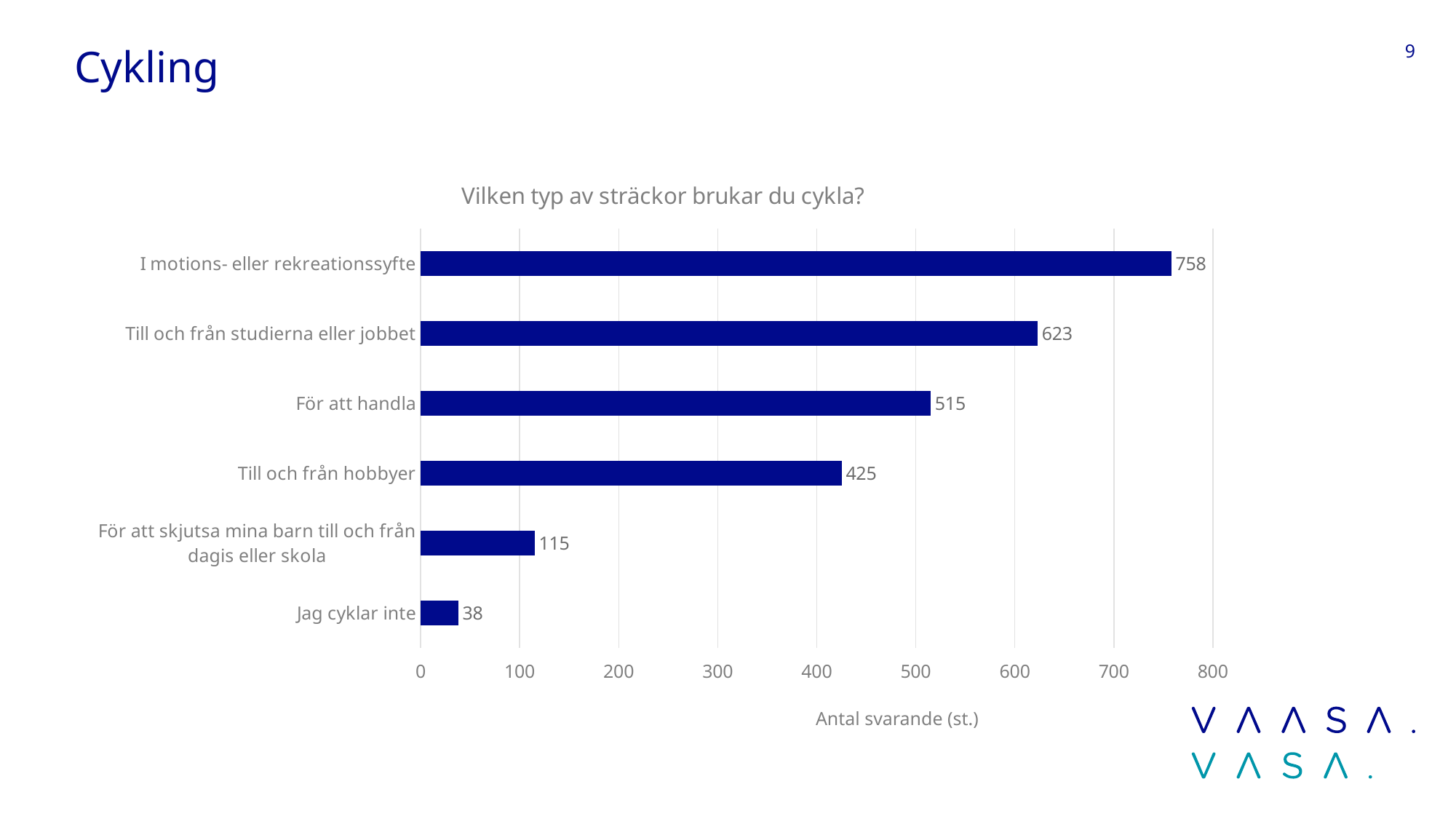
Which category has the lowest value? Jag cyklar inte What kind of chart is shown on the slide? bar chart What is the title of the chart? Vilken typ av sträckor brukar du cykla? How many categories are shown in the chart? 6 What is the value for "I motions- eller rekreationssyfte"? 758 Is the value for "Till och från hobbyer" greater or less than 400? greater Which category has the highest value? I motions- eller rekreationssyfte What is the value for "Till och från studierna eller jobbet"? 623 What is the value for "Jag cyklar inte"? 38 What is the value for "För att handla"? 515 Which is larger: the value for "Till och från hobbyer" or the value for "För att skjutsa mina barn till och från dagis eller skola"? Till och från hobbyer What is the difference between the values for "Till och från studierna eller jobbet" and "För att handla"? 108